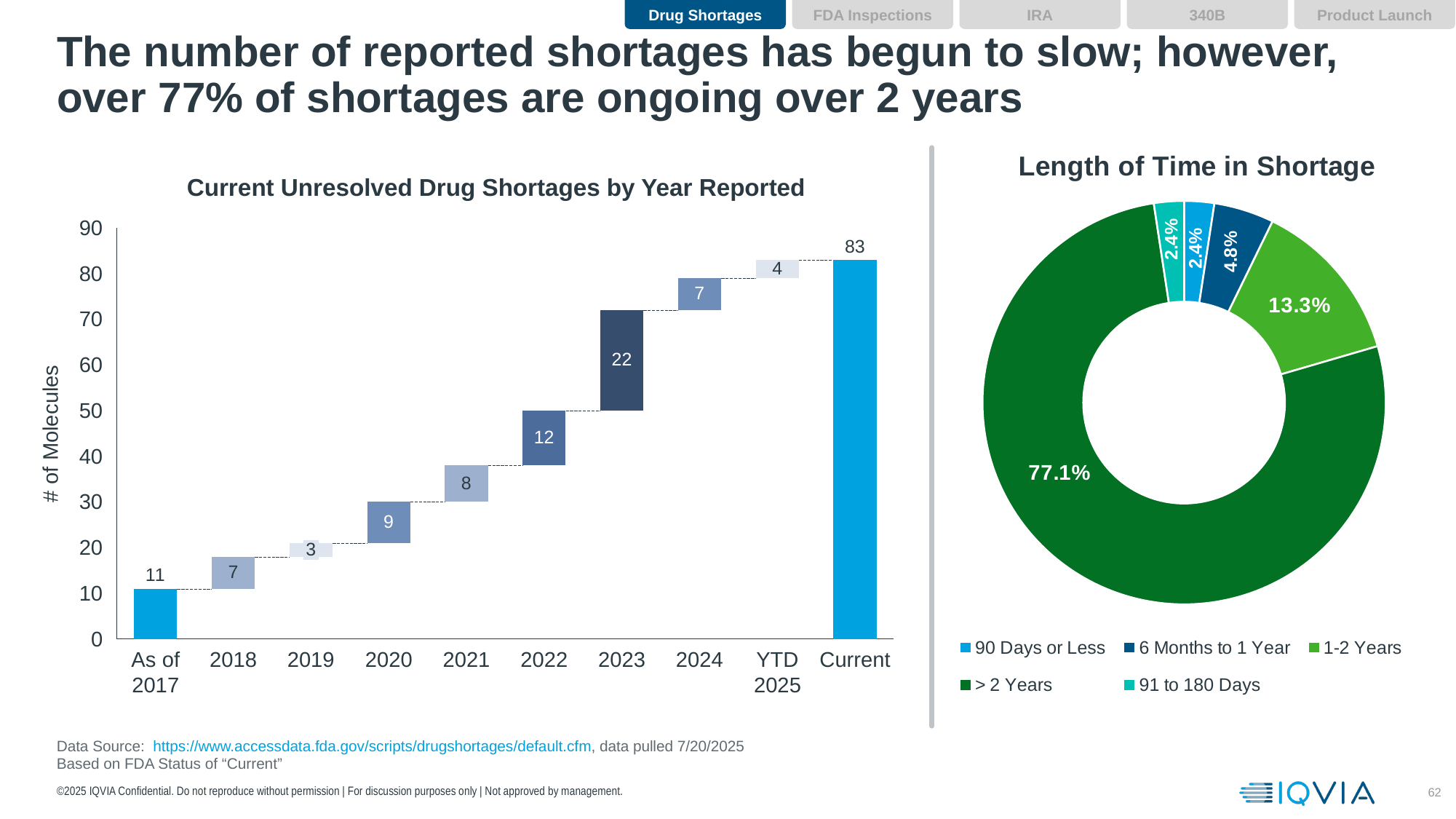
In the 'Current Unresolved Drug Shortages by Year Reported' chart, what is the value of the 'Current' bar? 83 In the 'Length of Time in Shortage' chart, what share of shortages have lasted more than 2 years? 77.1% In the 'Current Unresolved Drug Shortages by Year Reported' chart, which year has the smallest number of reported shortages added? 2019 In the 'Length of Time in Shortage' chart, how many categories does the legend list? 5 In the 'Current Unresolved Drug Shortages by Year Reported' chart, what is the difference between the 2023 value and the 2022 value? 10 In the 'Length of Time in Shortage' chart, what share of shortages have lasted 1-2 years? 13.3% In the 'Current Unresolved Drug Shortages by Year Reported' chart, how many categories are shown on the x axis? 10 In the 'Current Unresolved Drug Shortages by Year Reported' chart, which year has the largest number of reported shortages added? 2023 In the 'Current Unresolved Drug Shortages by Year Reported' chart, how many molecules were reported in 2023? 22 In the 'Length of Time in Shortage' chart, what is the difference between the '> 2 Years' share and the '1-2 Years' share? 63.8% What kind of chart is 'Current Unresolved Drug Shortages by Year Reported'? Bar chart (waterfall) In the 'Current Unresolved Drug Shortages by Year Reported' chart, which is larger, the value for 2020 or the value for 2021? 2020